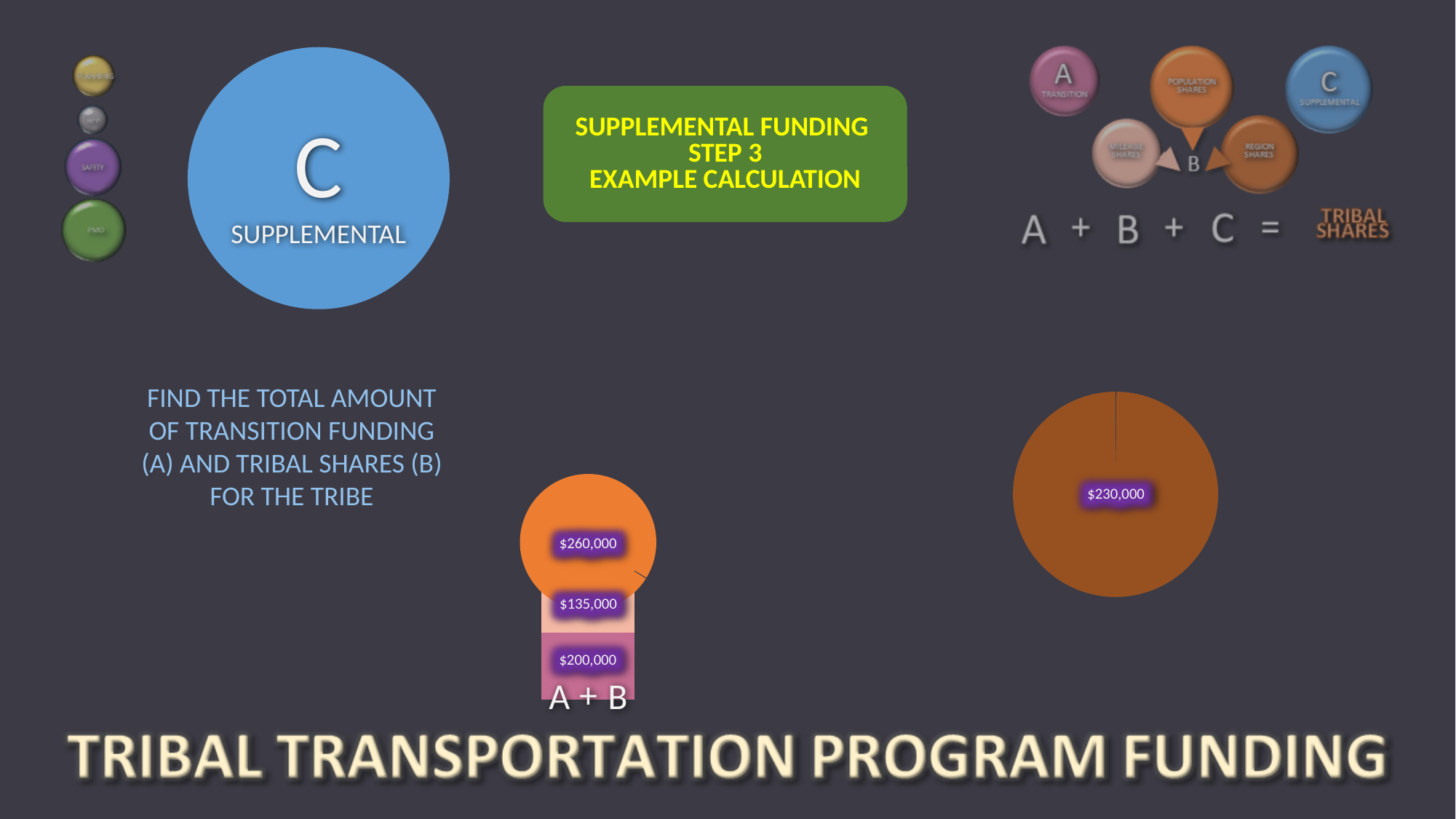
Of all the dollar values printed on the charts, which is the lowest? $135,000 In the stacked bar labeled A + B, what value is printed on the bottom (pink) segment? $200,000 What is the difference between the orange circle's value ($260,000) and the brown pie chart's value ($230,000)? $30,000 What value is printed on the orange circle above the A + B bar? $260,000 What label appears directly beneath the stacked bar in the lower middle of the slide? A + B Of all the dollar values printed on the charts, which is the highest? $260,000 What is the difference between the two segments of the A + B bar, $200,000 and $135,000? $65,000 What kind of chart is the brown chart on the right side of the slide? pie chart In the stacked bar labeled A + B, what value is printed on the upper (light pink) segment? $135,000 In the A + B bar, which is larger: the $200,000 segment or the $135,000 segment? $200,000 Which is larger: the value on the orange circle or the value on the brown pie chart on the right? $260,000 What value is printed on the brown pie chart on the right side of the slide? $230,000